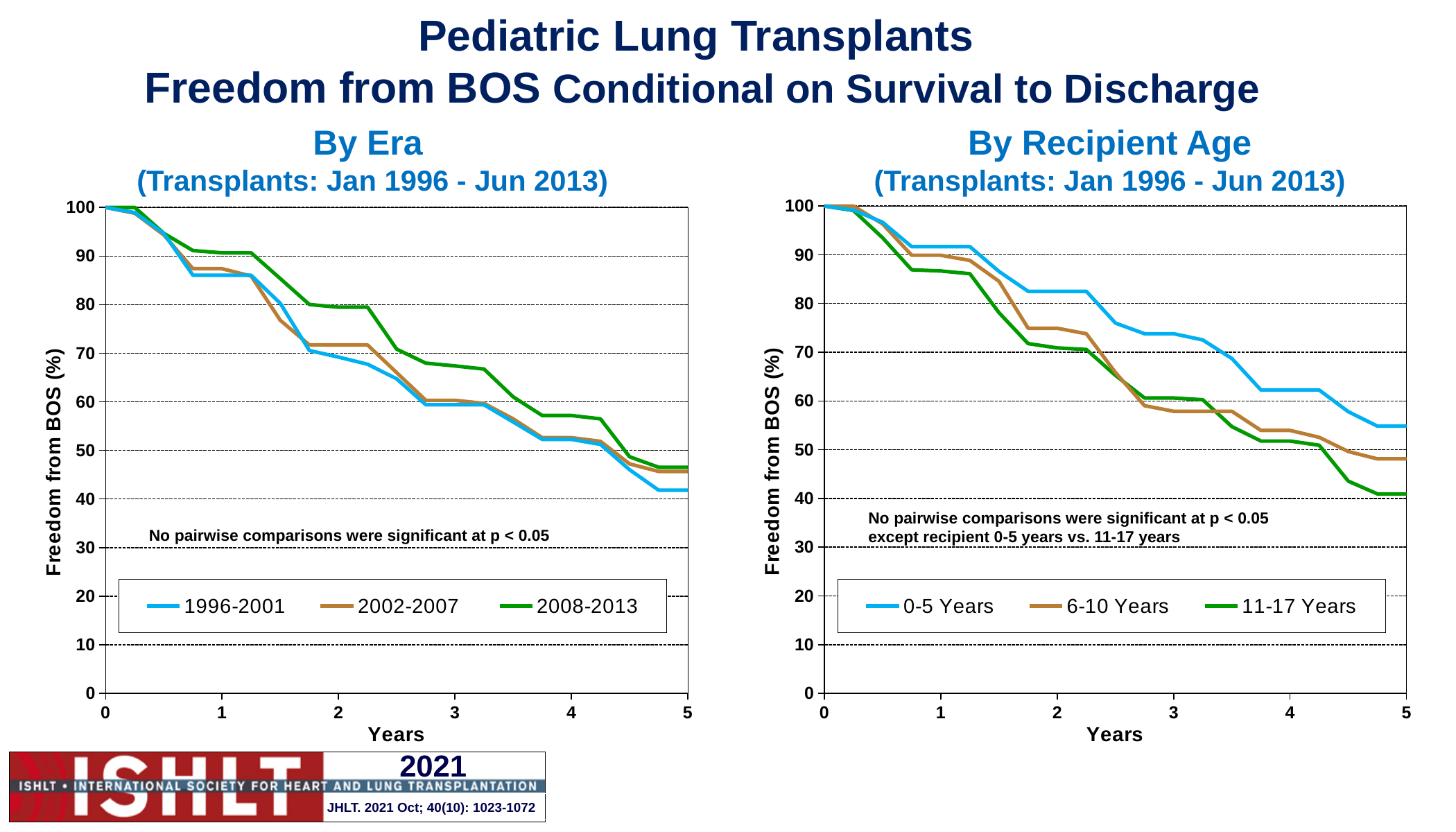
In the 'By Era' chart, do the values rise or fall as years increase? fall In the 'By Era' chart, which era has the highest freedom from BOS at year 2? 2008-2013 What kind of chart is the 'By Era' chart on the left? line chart In the 'By Era' chart, what is the freedom from BOS value for all eras at year 0? 100 In the 'By Era' chart, which era has the lowest freedom from BOS at year 5? 1996-2001 In the 'By Era' chart, is the value for 1996-2001 at year 5 greater or less than 50? less How many series does the legend of the 'By Recipient Age' chart list? 3 In the 'By Recipient Age' chart, which age group has the highest freedom from BOS at year 5? 0-5 Years In the 'By Recipient Age' chart, which age group has the lowest freedom from BOS at year 5? 11-17 Years In the 'By Recipient Age' chart, is the value for 0-5 Years at year 2 greater or less than 80? greater In the 'By Recipient Age' chart, which pairwise comparison is noted as significant at p < 0.05? recipient 0-5 years vs. 11-17 years